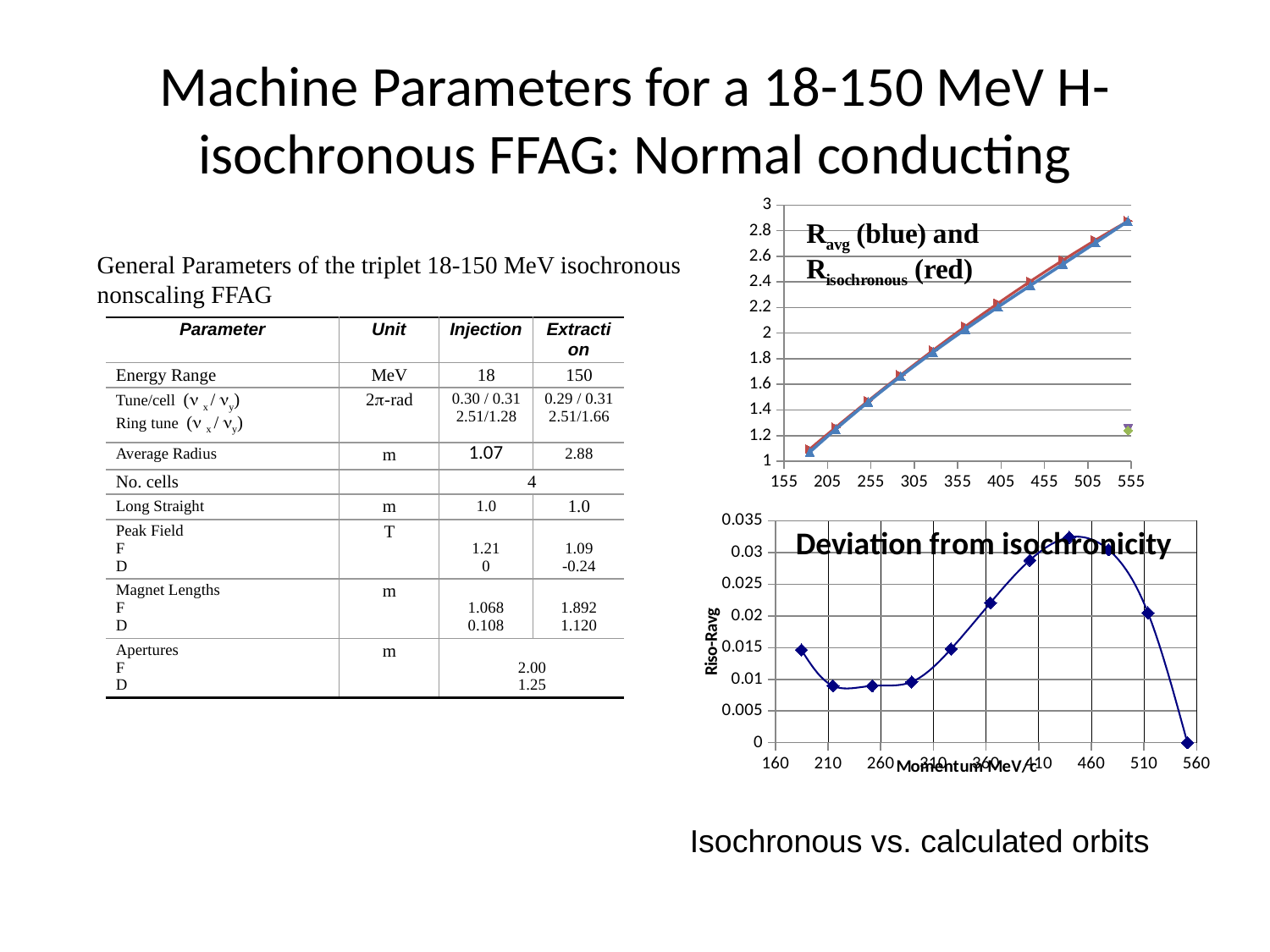
In the 'Deviation from isochronicity' chart, what is the label on the x axis? Momentum MeV/c In the top-right chart, which colour represents Risochronous? red In the 'Deviation from isochronicity' chart, what is the label on the y axis? Riso-Ravg In the top-right chart (Ravg and Risochronous), is the value of the rightmost red point greater or less than 2.6? greater What kind of chart is the 'Deviation from isochronicity' chart? line chart In the top-right chart (Ravg and Risochronous), do the values rise or fall as momentum increases along the x axis? rise In the 'Deviation from isochronicity' chart, does the curve rise or fall between momentum 460 and 560? fall In the 'Deviation from isochronicity' chart, which is larger: the value of the leftmost point or the value of the rightmost point? the leftmost point In the 'Deviation from isochronicity' chart, is the value of the last (rightmost) point greater or less than 0.005? less In the top-right chart (Ravg and Risochronous), is the value of the leftmost blue point greater or less than 1.2? less